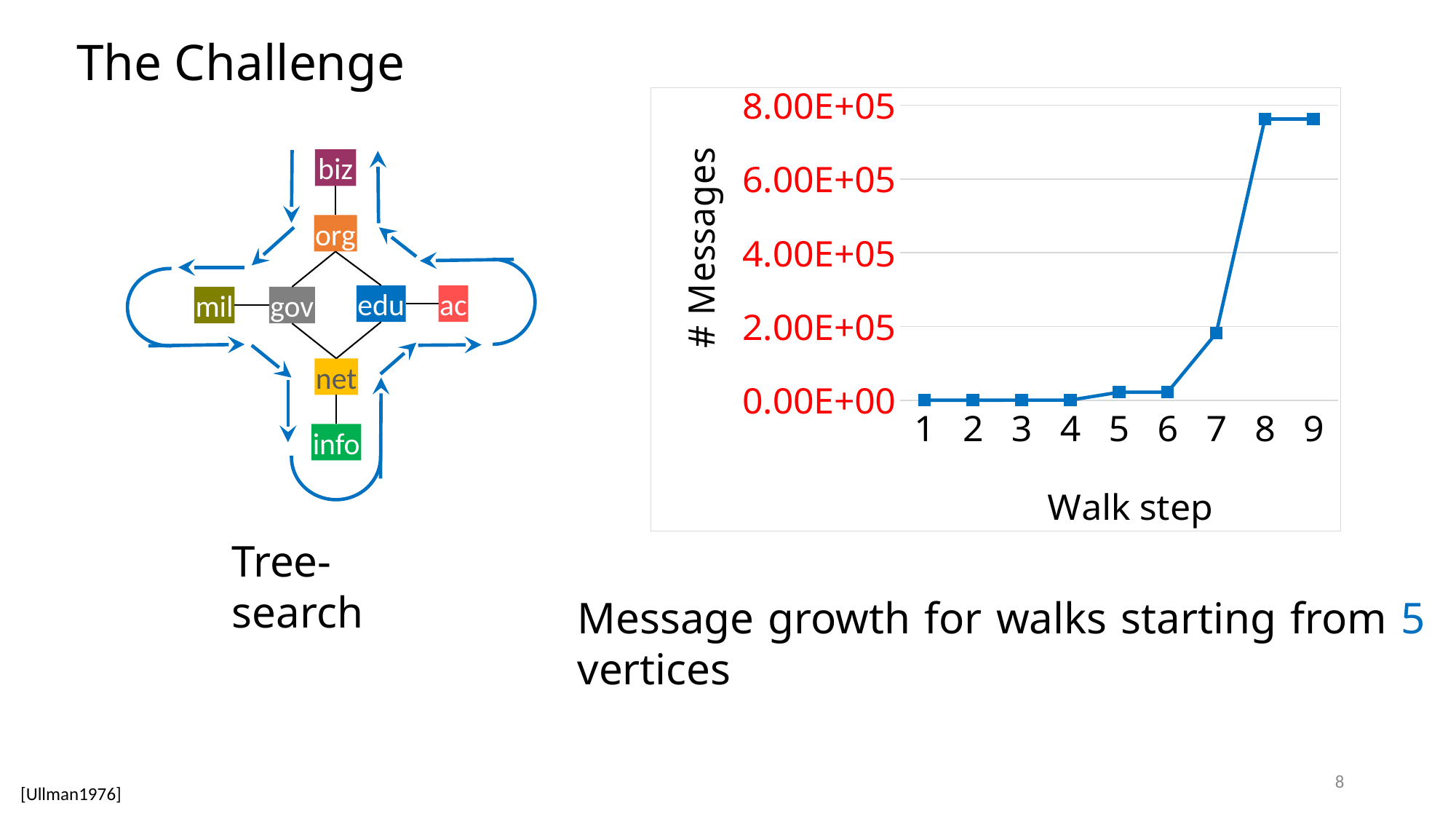
Is the value for walk step 1 greater or less than 2.00E+05? less Which has a larger number of messages, walk step 7 or walk step 8? walk step 8 Is the value for walk step 7 greater or less than 4.00E+05? less What is the label of the y axis of the chart? # Messages Do the values in the chart generally rise or fall as the walk step increases? rise How many walk steps are plotted on the x axis of the chart? 9 Which has a larger number of messages, walk step 2 or walk step 7? walk step 7 Is the value for walk step 8 greater or less than 6.00E+05? greater What kind of chart is shown on the slide? line chart What is the label of the x axis of the chart? Walk step